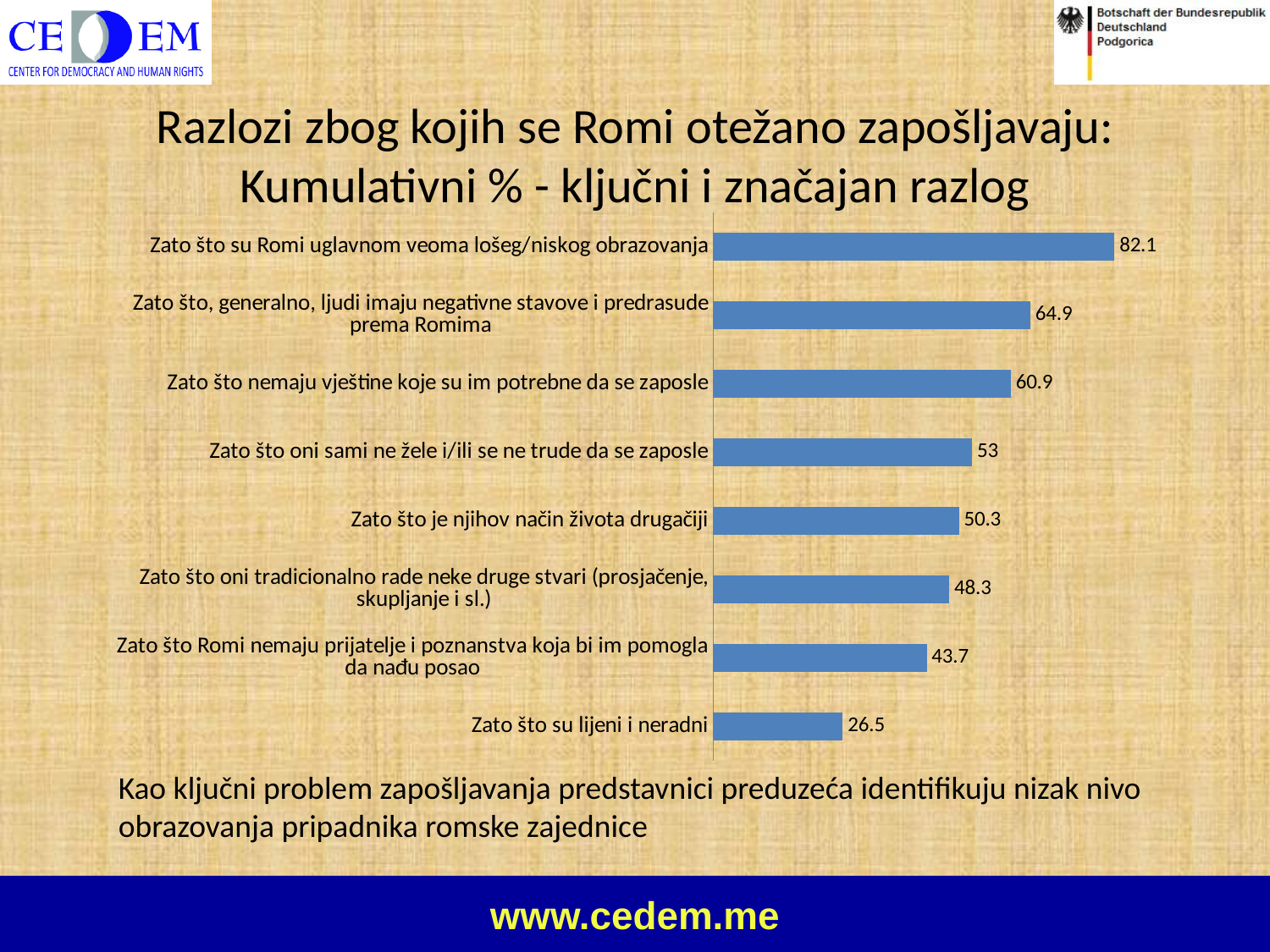
Which category has the highest value? Zato što su Romi uglavnom veoma lošeg/niskog obrazovanja What is the difference between the values for "Zato što su Romi uglavnom veoma lošeg/niskog obrazovanja" and "Zato što su lijeni i neradni"? 55.6 Which is larger: the value for "Zato što oni sami ne žele i/ili se ne trude da se zaposle" or for "Zato što je njihov način života drugačiji"? Zato što oni sami ne žele i/ili se ne trude da se zaposle What is the difference between the values for "Zato što, generalno, ljudi imaju negativne stavove i predrasude prema Romima" and "Zato što nemaju vještine koje su im potrebne da se zaposle"? 4 What is the value for "Zato što su lijeni i neradni"? 26.5 What is the title of the chart? Razlozi zbog kojih se Romi otežano zapošljavaju: Kumulativni % - ključni i značajan razlog Which category has the lowest value? Zato što su lijeni i neradni How many categories are shown in the chart? 8 What kind of chart is shown on the slide? Bar chart What is the value for "Zato što nemaju vještine koje su im potrebne da se zaposle"? 60.9 What is the value for "Zato što Romi nemaju prijatelje i poznanstva koja bi im pomogla da nađu posao"? 43.7 What is the value for "Zato što su Romi uglavnom veoma lošeg/niskog obrazovanja"? 82.1